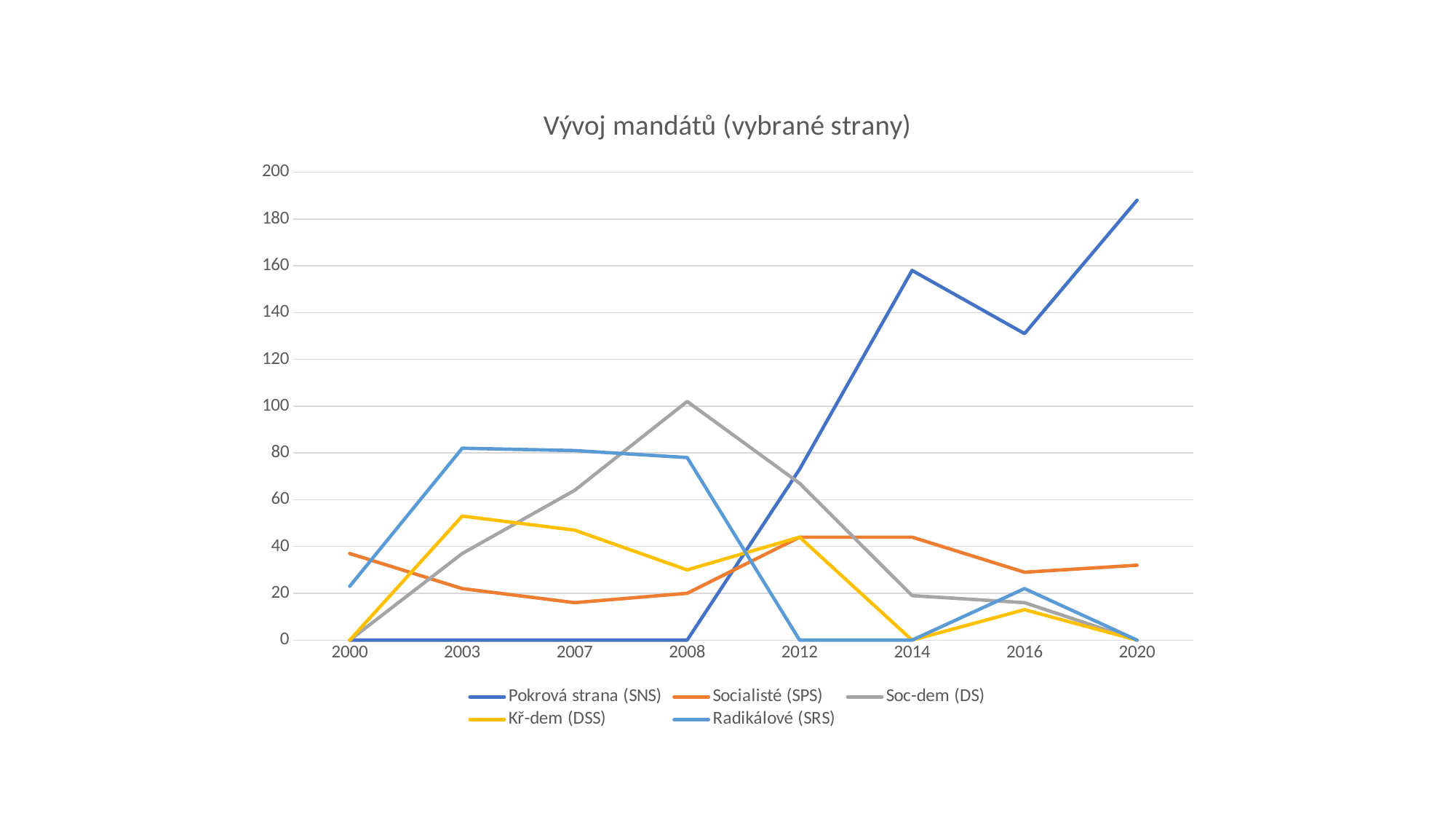
Is the value for Kř-dem (DSS) in 2003 greater or less than 40? greater How many series does the legend list? 5 Does the value for Socialisté (SPS) rise or fall from 2000 to 2007? fall How many years are shown on the x axis? 8 In 2008, which is larger: Soc-dem (DS) or Radikálové (SRS)? Soc-dem (DS) What kind of chart is shown on the slide? line chart Is the value for Pokrová strana (SNS) in 2016 greater or less than 140? less Is the value for Soc-dem (DS) in 2008 greater or less than 80? greater Which series reaches the highest value on the chart? Pokrová strana (SNS) What is the value for Radikálové (SRS) in 2014? 0 What is the value for Pokrová strana (SNS) in 2003? 0